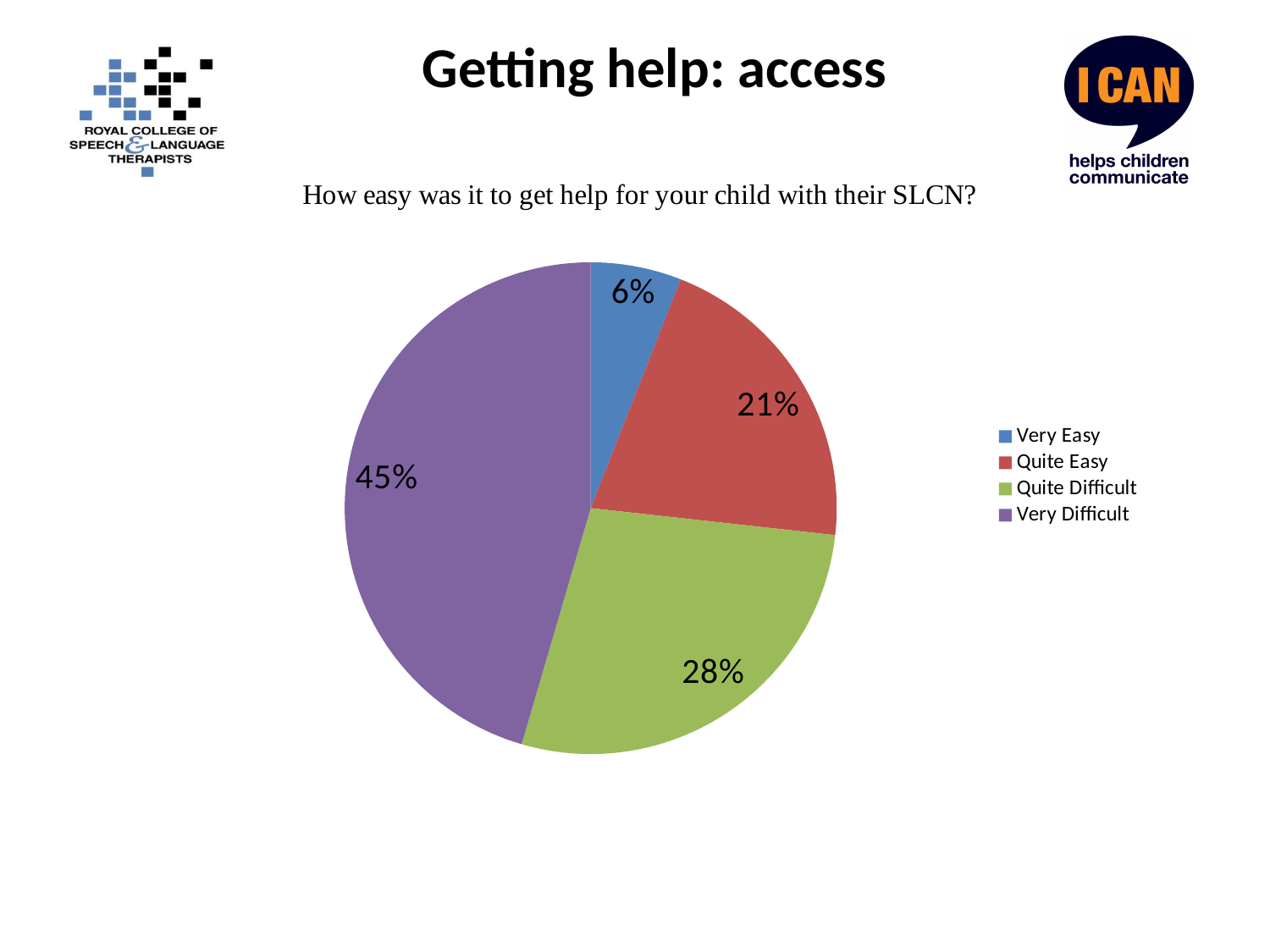
Which response category has the largest share of the pie? Very Difficult What is the difference in percentage points between the Very Difficult and Quite Difficult slices? 17 What is the combined percentage of respondents who found it Quite Difficult or Very Difficult? 73% What percentage of respondents said it was Quite Difficult to get help? 28% How many response categories are shown in the pie chart? 4 What type of chart is shown on the slide? Pie chart What percentage of respondents said it was Very Difficult to get help? 45% What percentage of respondents said it was Very Easy to get help for their child? 6% What percentage of respondents said it was Quite Easy to get help? 21% Which response category has the smallest share of the pie? Very Easy What colour represents the Very Difficult category in the pie chart? Purple Which slice is larger: Quite Easy or Quite Difficult? Quite Difficult